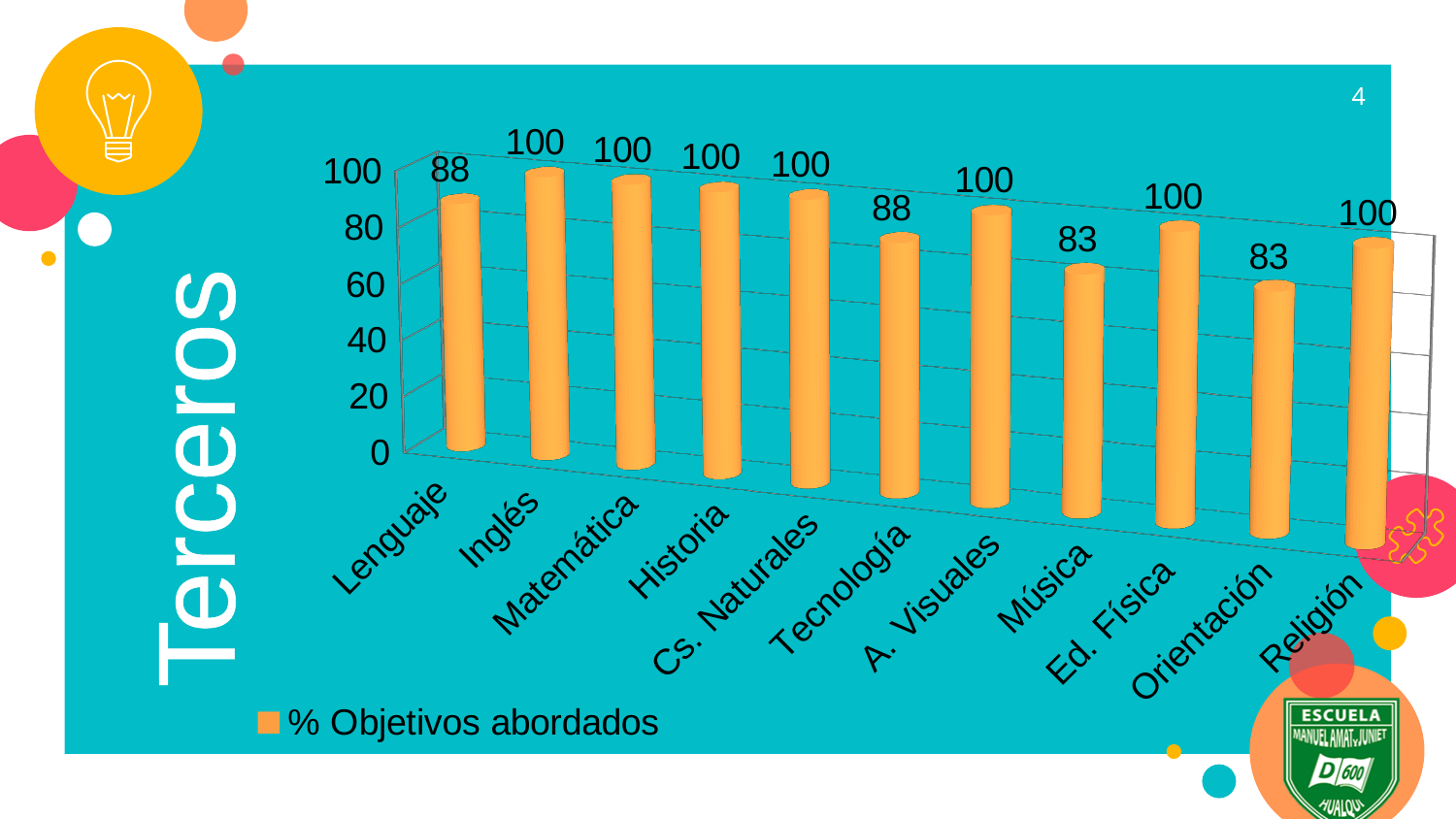
What is the legend entry for the series? % Objetivos abordados Which is larger, the value for Historia or the value for Tecnología? Historia What is the value for Lenguaje? 88 What is the value for Religión? 100 What is the difference between the values for Inglés and Orientación? 17 What is the value for Música? 83 What kind of chart is shown on the slide? bar chart What is the difference between the values for Lenguaje and Música? 5 Which categories have the lowest value? Música and Orientación How many categories are shown on the x axis? 11 How many series does the legend list? 1 What is the value for Tecnología? 88